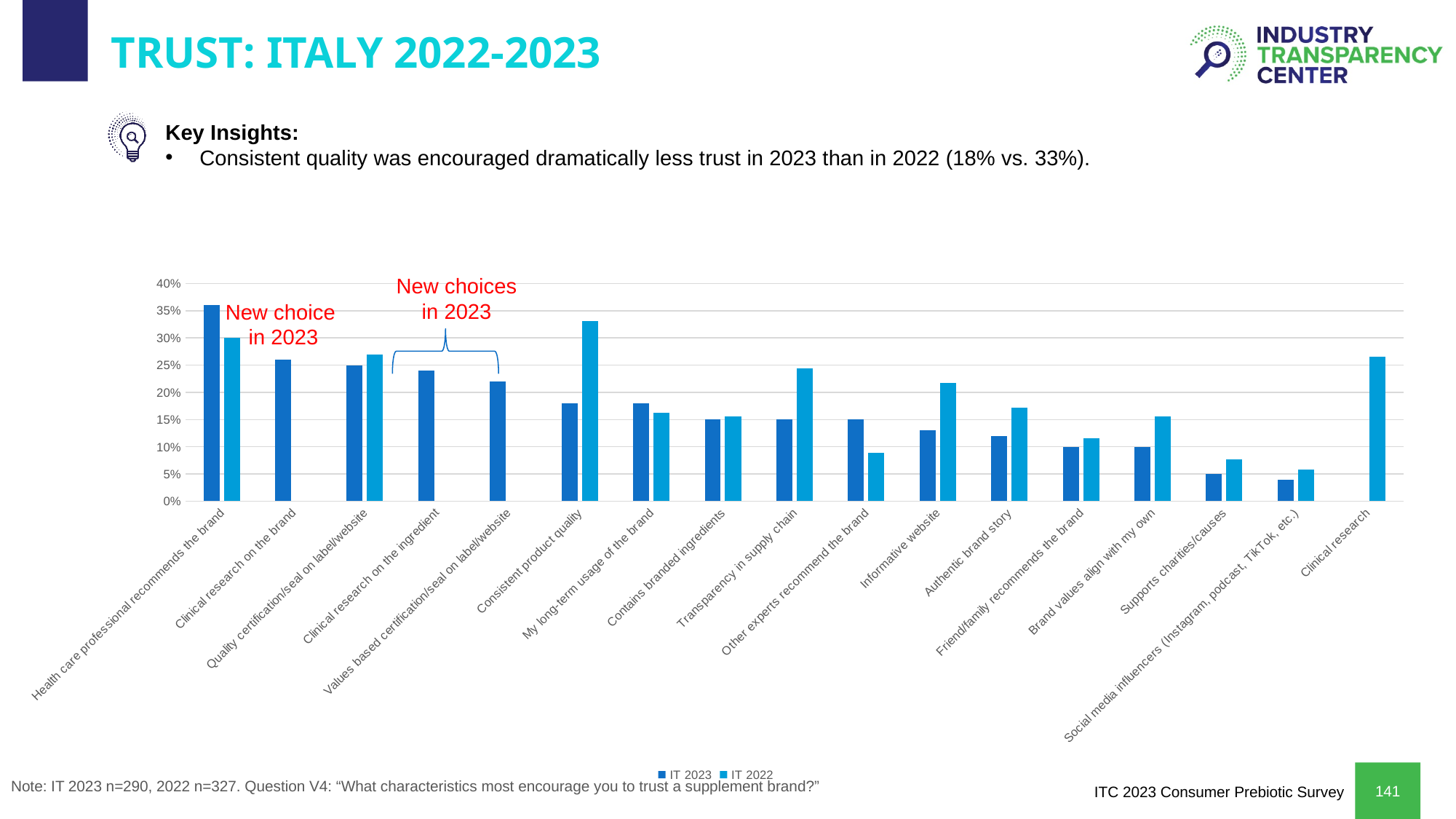
By how many percentage points did the value for Consistent product quality fall from 2022 to 2023? 15 percentage points How many categories are shown along the x axis of the chart? 17 How many series does the chart legend list? 2 Is the IT 2023 value for Health care professional recommends the brand greater or less than 30%? greater For Other experts recommend the brand, which series has the larger value, IT 2023 or IT 2022? IT 2023 Is the IT 2022 value for Other experts recommend the brand greater or less than 10%? less For Informative website, which series has the larger value, IT 2023 or IT 2022? IT 2022 What was the IT 2022 value for Consistent product quality? 33% Which category has the highest IT 2023 value? Health care professional recommends the brand What kind of chart is shown on the slide? Bar chart Which series is shown in the darker blue bars according to the legend? IT 2023 What was the IT 2023 value for Consistent product quality? 18%